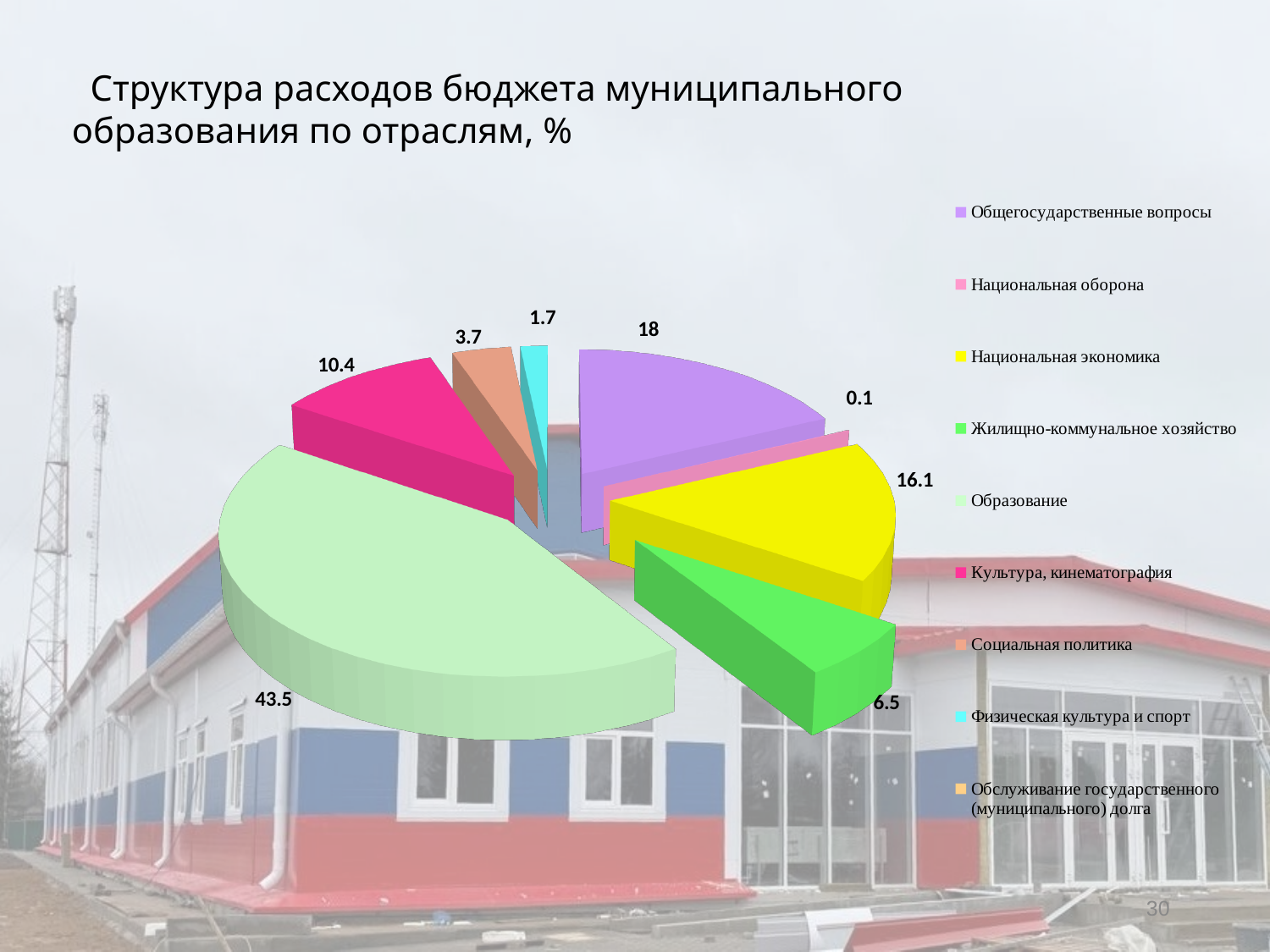
What is the value for Жилищно-коммунальное хозяйство? 6.5 What is the value for Общегосударственные вопросы? 18 What is the value for Национальная экономика? 16.1 Which is larger, the value for Социальная политика or the value for Физическая культура и спорт? Социальная политика What is the value for Национальная оборона? 0.1 What is the difference between the values for Общегосударственные вопросы and Национальная экономика? 1.9 What is the title of the slide? Структура расходов бюджета муниципального образования по отраслям, % What is the value for Культура, кинематография? 10.4 How many entries does the legend list? 9 What is the value for Образование? 43.5 Which category has the largest share of the pie? Образование What kind of chart is shown on the slide? pie chart